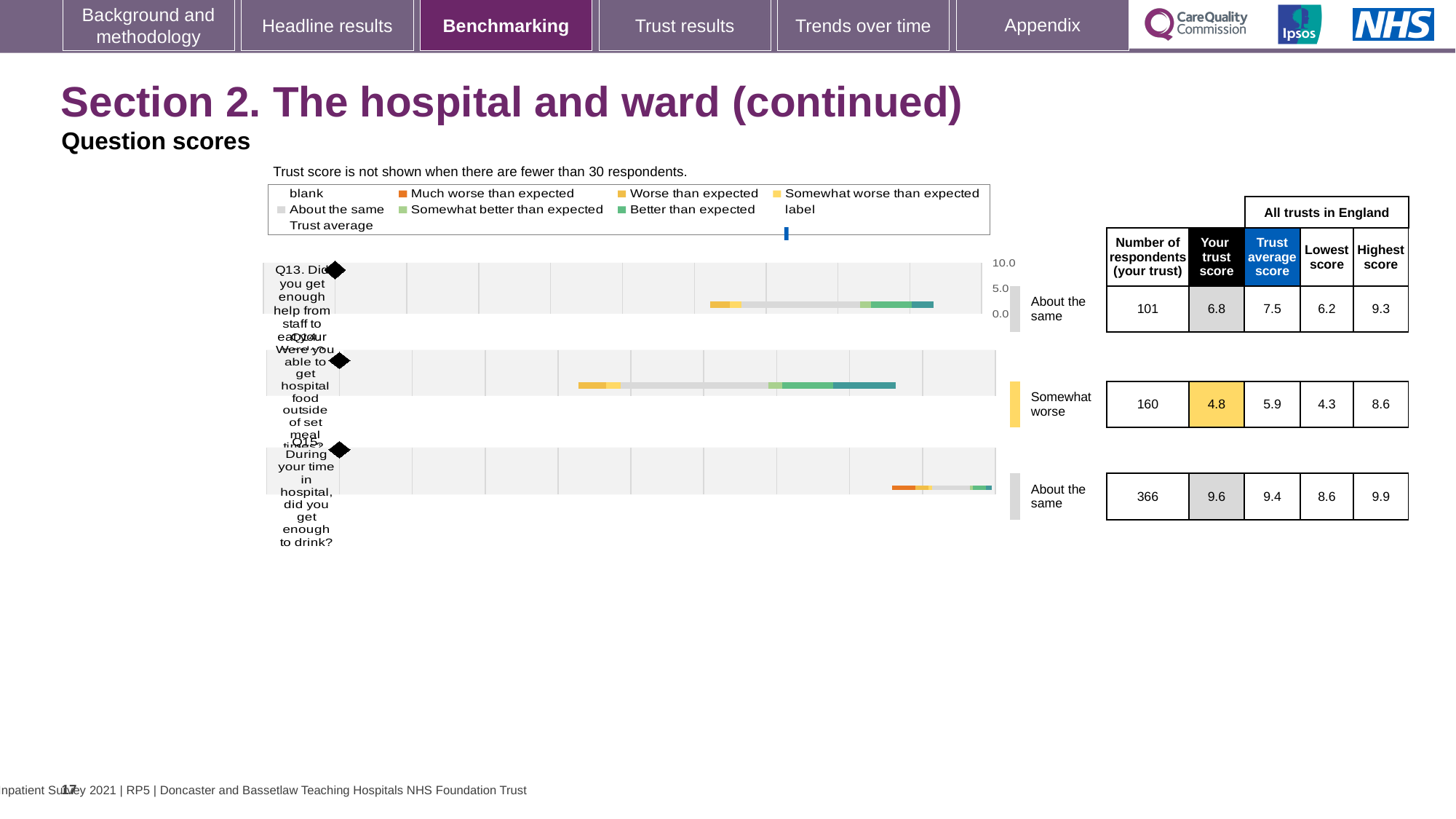
How many respondents answered Q14 (Were you able to get hospital food outside of set meal times?)? 160 What is the trust average score for Q15 (During your time in hospital, did you get enough to drink?)? 9.4 For Q14, which is larger: the trust score or the trust average score? Trust average score Which question has the lowest trust score? Q14 What benchmark category is shown for Q14? Somewhat worse What kind of chart is used to show the question scores on this slide? Bar chart According to the note above the chart, when is the trust score not shown? When there are fewer than 30 respondents What is the trust score for Q13 (Did you get enough help from staff to eat your meals?)? 6.8 Which question has the highest trust score? Q15 How many questions are plotted in the chart? 3 What is the difference between the trust average score and the trust score for Q13? 0.7 What is the highest score across all trusts in England for Q14? 8.6